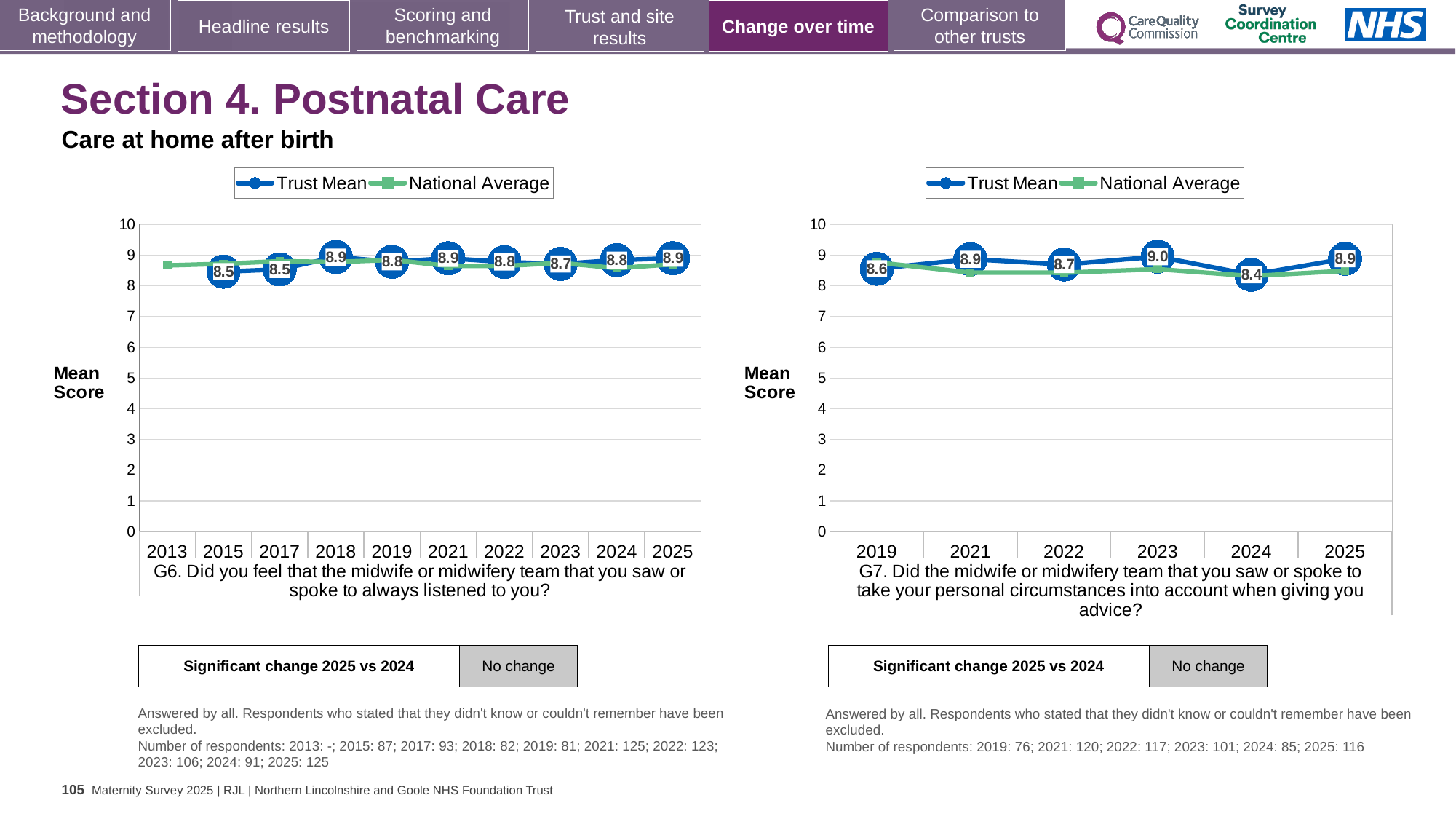
What does the box below the right chart (G7) say about the significant change 2025 vs 2024? No change In the right chart (G7), which year has the lowest Trust Mean score? 2024 In the right chart (G7), what is the Trust Mean score for 2024? 8.4 How many series does the legend of the left chart (G6) list? 2 What type of chart is the left chart (G6)? Line chart How many years are shown on the x axis of the right chart (G7)? 6 In the right chart (G7), is the National Average value for 2025 greater or less than 8? greater In the right chart (G7), which year has the highest Trust Mean score? 2023 In the left chart (G6), what is the Trust Mean score for 2015? 8.5 In the right chart (G7), what is the difference between the Trust Mean scores for 2023 and 2024? 0.6 In the left chart (G6), what is the Trust Mean score for 2025? 8.9 In the left chart (G6), is the Trust Mean score for 2018 or 2023 higher? 2018